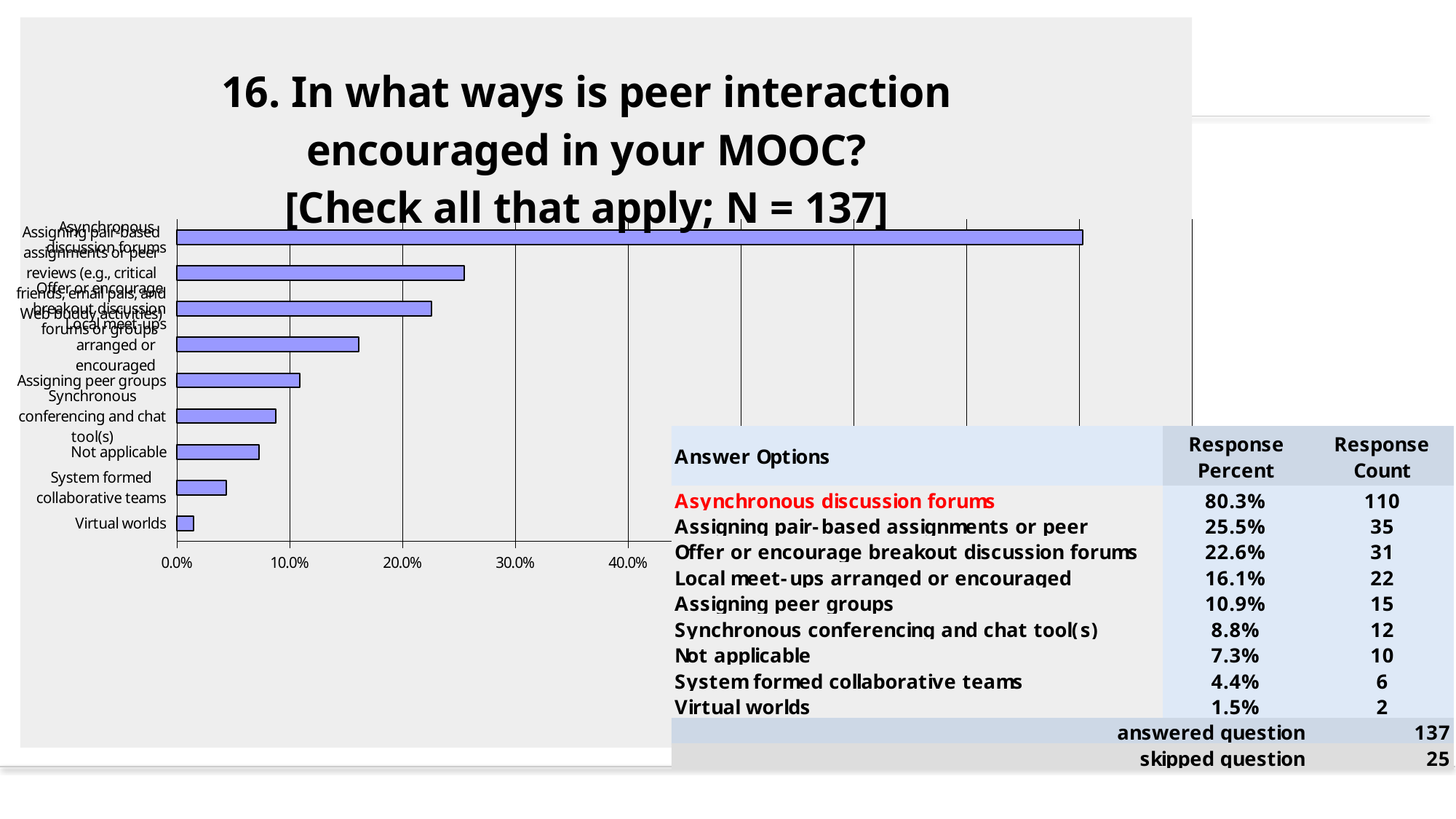
What is the response percent for Local meet-ups arranged or encouraged? 16.1% What is the response count for Assigning peer groups? 15 How many answer options are plotted in the chart? 9 What is the response percent for Asynchronous discussion forums? 80.3% Which is larger, the response percent for Offer or encourage breakout discussion forums or for Synchronous conferencing and chat tool(s)? Offer or encourage breakout discussion forums Which answer option has the highest response percent? Asynchronous discussion forums How many respondents answered the question, according to the table? 137 Which answer option has the lowest response percent? Virtual worlds What kind of chart is shown on the slide? bar chart What is the response percent for System formed collaborative teams? 4.4% Is the value for Asynchronous discussion forums greater or less than 40.0%? greater What is the difference in response percent between Assigning pair-based assignments or peer reviews and Not applicable? 18.2%